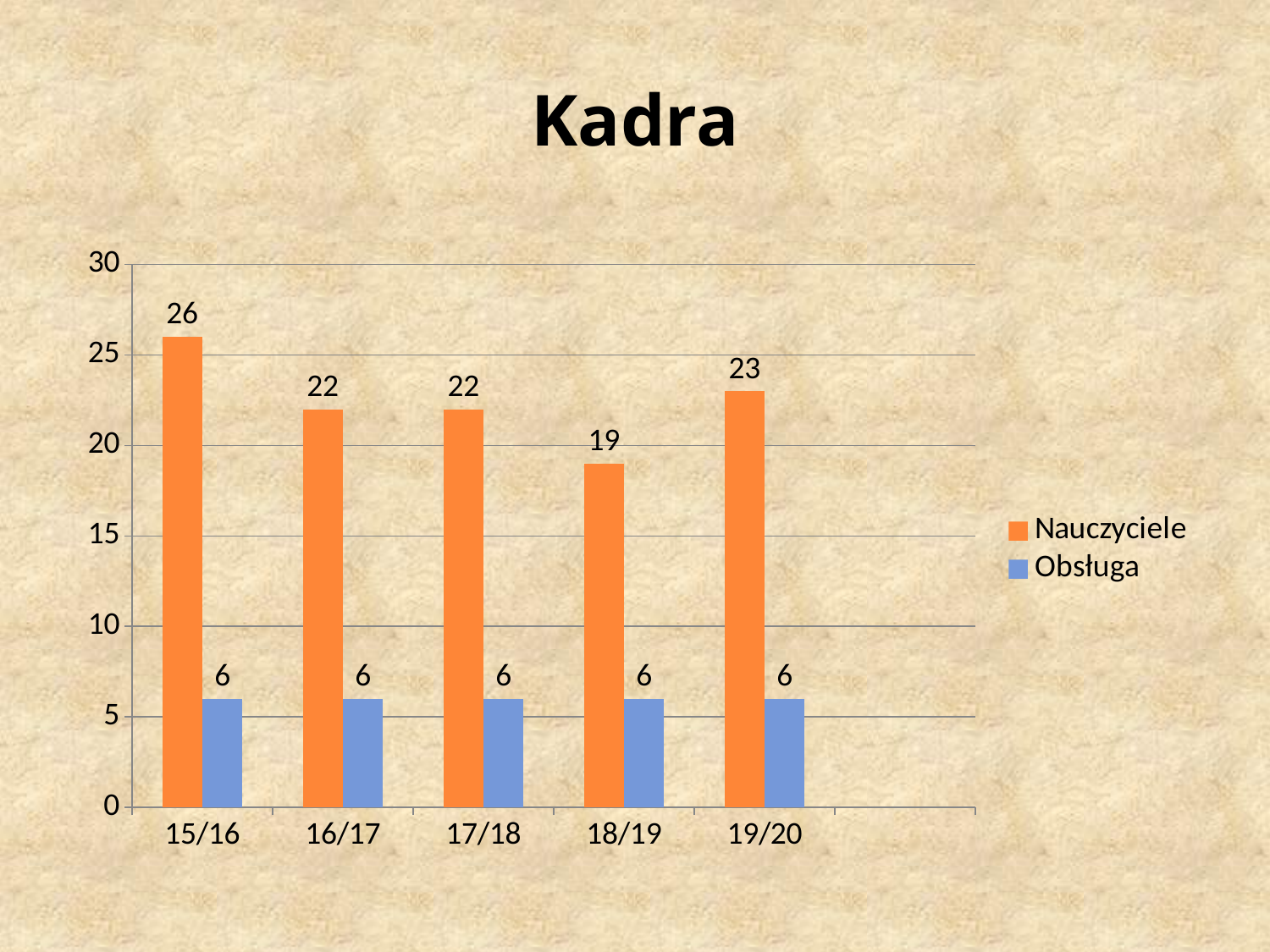
What is the value for Nauczyciele in 18/19? 19 What is the value for Nauczyciele in 15/16? 26 Which is larger, the Nauczyciele value for 19/20 or for 16/17? 19/20 Is the value for Nauczyciele in 19/20 greater or less than 20? greater What is the value for Obsługa in 17/18? 6 Which year has the lowest value for Nauczyciele? 18/19 How many series does the legend list? 2 How many years are shown on the x axis? 5 What is the difference between the Nauczyciele values for 15/16 and 18/19? 7 What is the title of the chart? Kadra Which year has the highest value for Nauczyciele? 15/16 What kind of chart is shown on the slide? bar chart